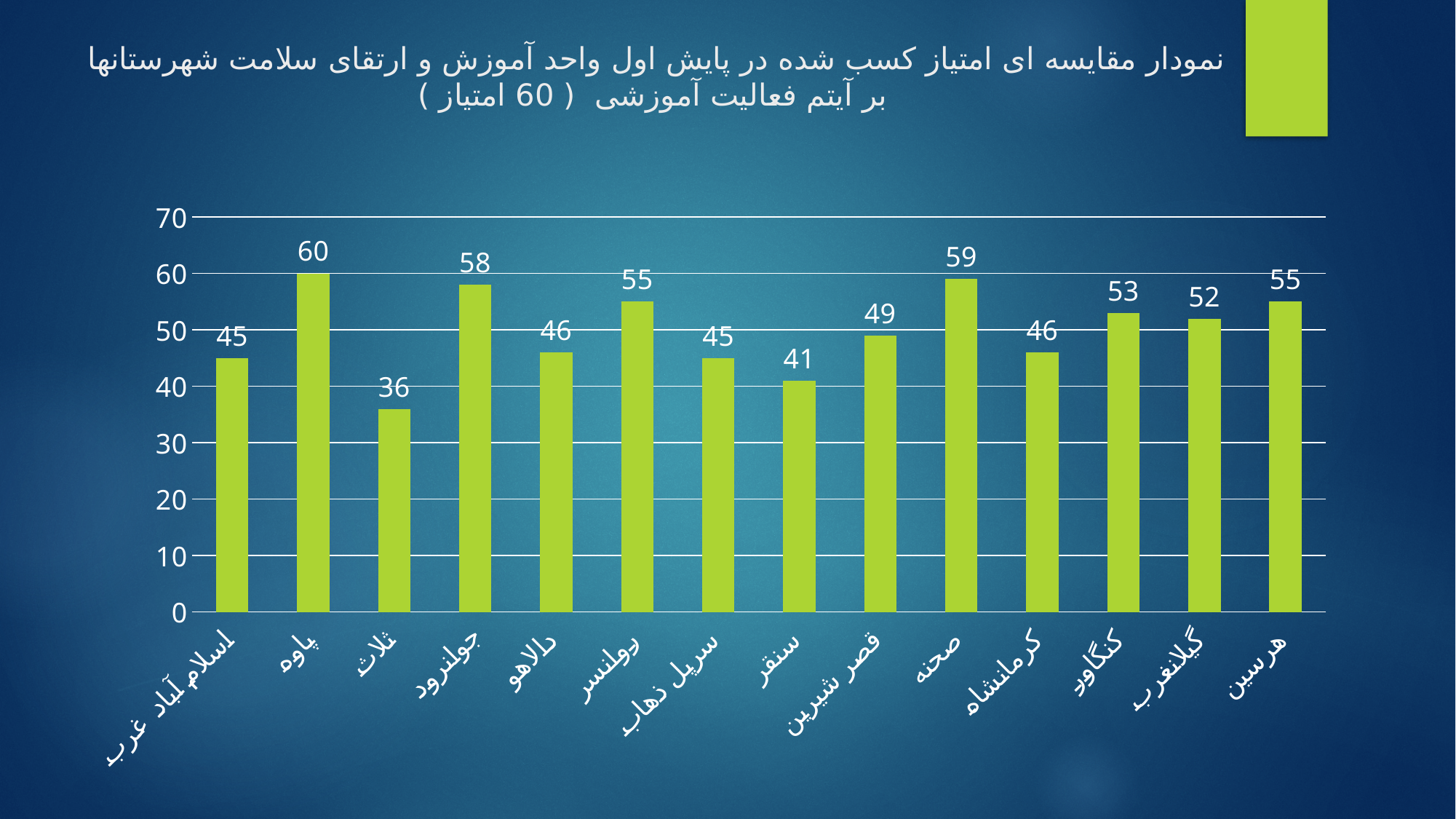
What is the value for پاوه? 60 Is the value for کرمانشاه greater or less than 50? less Which category has the lowest value? ثلاث Which category has the highest value? پاوه What is the difference between the values for صحنه and قصر شیرین? 10 What is the value for سنقر? 41 How many categories are shown on the x axis? 14 What colour are the bars in the chart? green What is the difference between the values for پاوه and ثلاث? 24 What is the value for کنگاور? 53 What kind of chart is shown on the slide? bar chart Which is larger, the value for جوانرود or the value for گیلانغرب? جوانرود